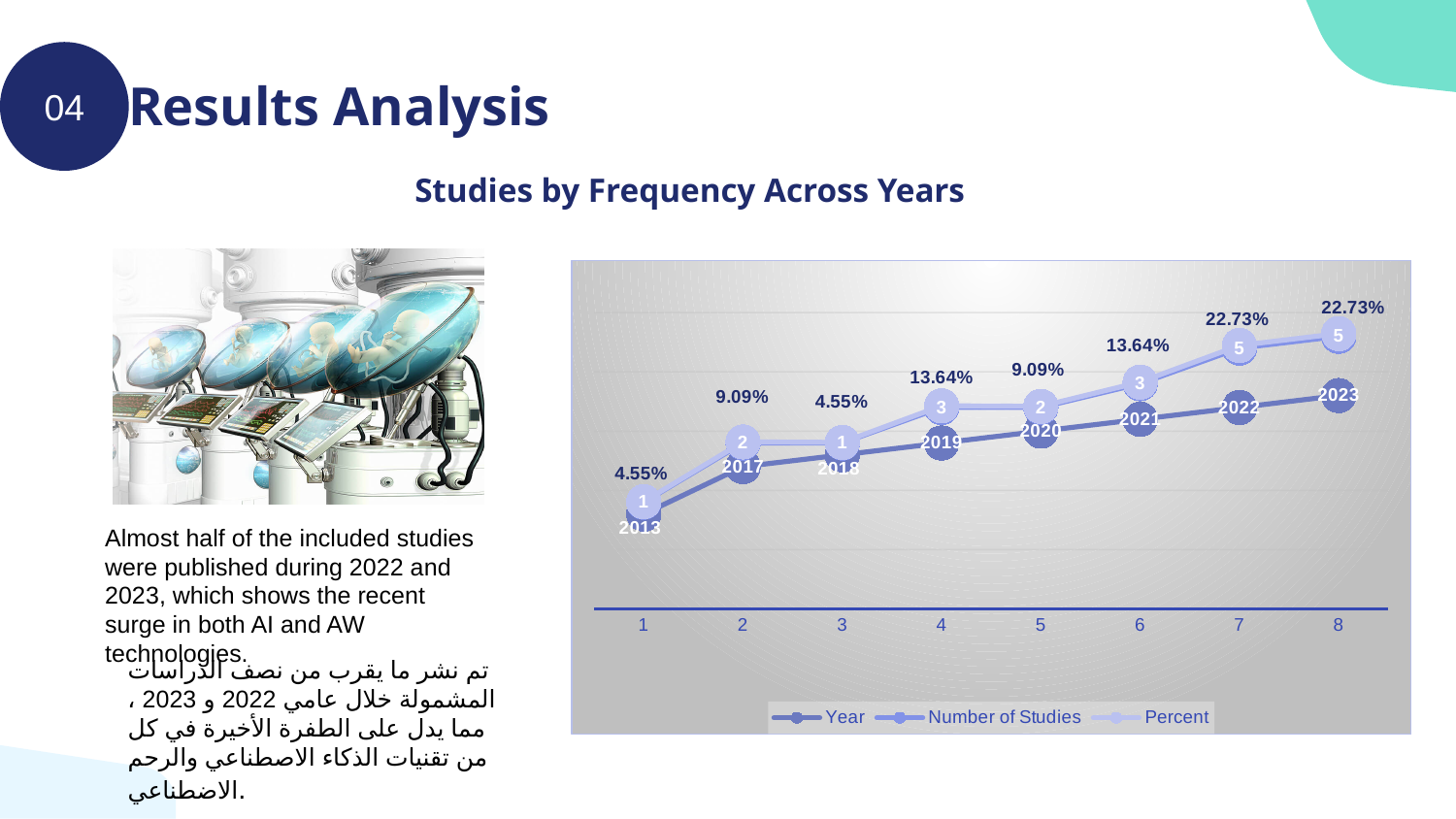
How many points are plotted along the x axis? 8 What is the Percent value for the year 2017? 9.09% What type of chart is shown on the slide? line chart What is the Number of Studies for the year 2019? 3 How many series does the legend list? 3 Which year has the lowest Percent value, 2013 or 2021? 2013 What is the title of the chart? Studies by Frequency Across Years What is the difference in Percent between 2021 and 2018? 9.09% Does the Number of Studies series generally rise or fall from 2013 to 2023? rise What is the Percent value for the year 2023? 22.73% What is the difference in Number of Studies between 2022 and 2020? 3 What is the Number of Studies for the year 2013? 1